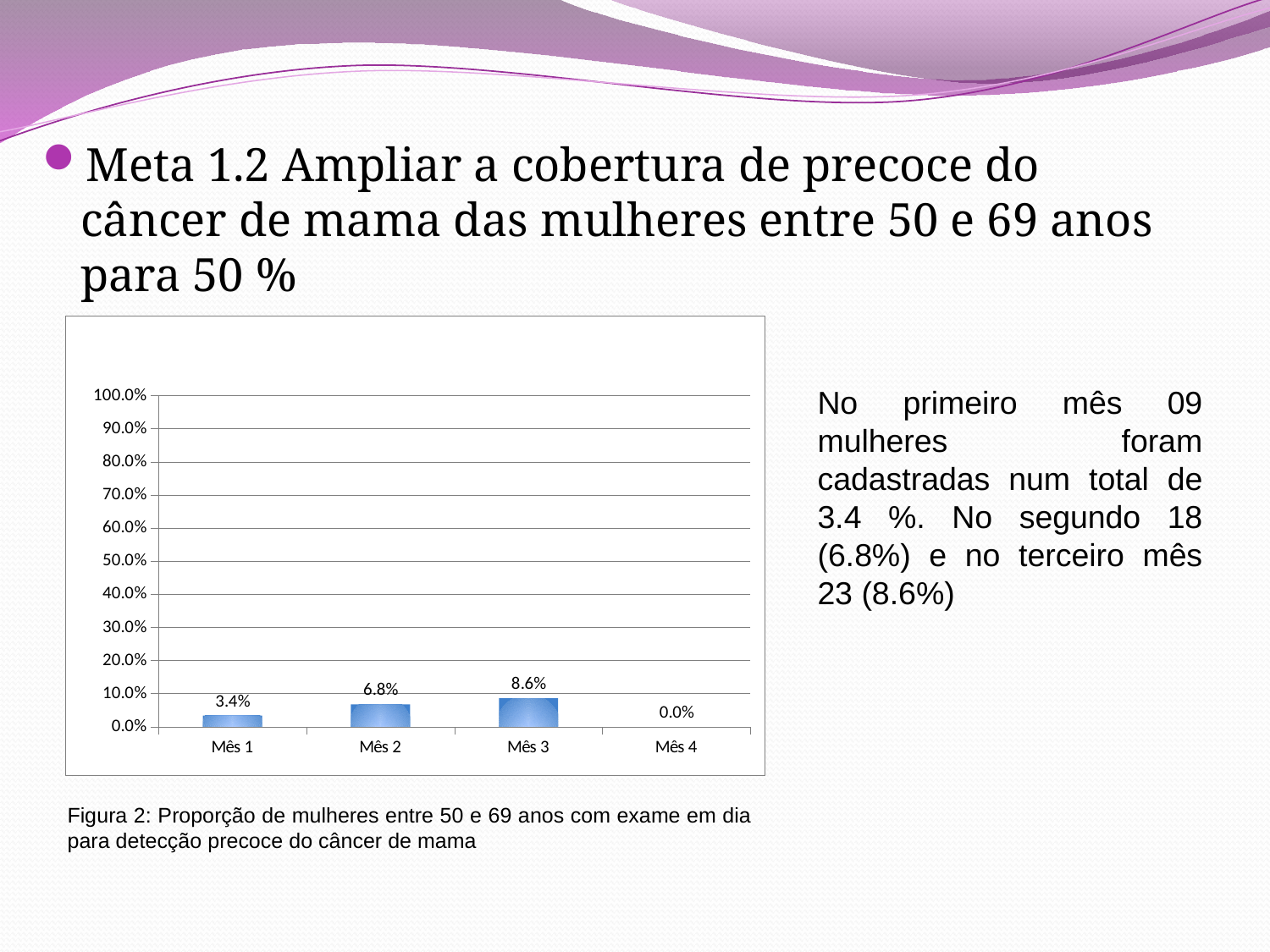
What is the value for Mês 2? 6.8% Which month has the lowest value? Mês 4 What kind of chart is shown on the slide? bar chart How many categories are shown on the x axis? 4 What is the value for Mês 3? 8.6% Is the value for Mês 3 greater or less than 10.0%? less What is the difference between the values for Mês 3 and Mês 1? 5.2% Which is larger, the value for Mês 2 or the value for Mês 3? Mês 3 Which month has the highest value? Mês 3 What is the difference between the values for Mês 2 and Mês 1? 3.4% What is the value for Mês 4? 0.0% What is the value for Mês 1? 3.4%